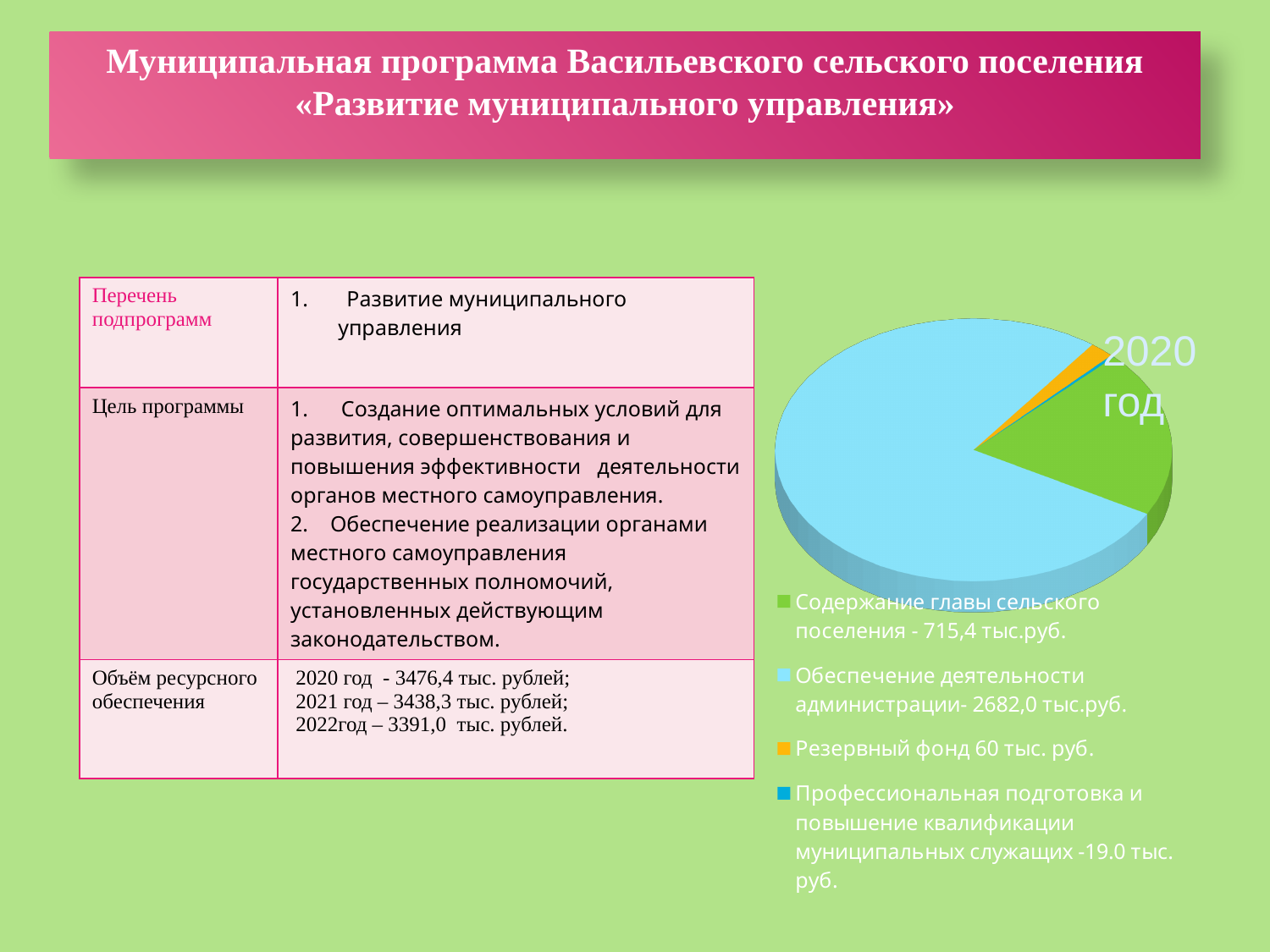
According to the legend, what is the value for Обеспечение деятельности администрации? 2682,0 тыс.руб. What is the total of all four categories in the pie chart, in тыс. руб.? 3476,4 According to the legend, what is the value for Резервный фонд? 60 тыс. руб. Which category has the largest slice of the pie chart? Обеспечение деятельности администрации Which is larger: Содержание главы сельского поселения or Резервный фонд? Содержание главы сельского поселения How many categories does the pie chart's legend list? 4 According to the legend, what is the value for Содержание главы сельского поселения? 715,4 тыс.руб. What kind of chart is shown on the slide? pie chart Which category has the smallest slice of the pie chart? Профессиональная подготовка и повышение квалификации муниципальных служащих What is the title shown on the pie chart? 2020 год What is the difference between Обеспечение деятельности администрации and Содержание главы сельского поселения, in тыс. руб.? 1966,6 According to the legend, what is the value for Профессиональная подготовка и повышение квалификации муниципальных служащих? 19.0 тыс. руб.